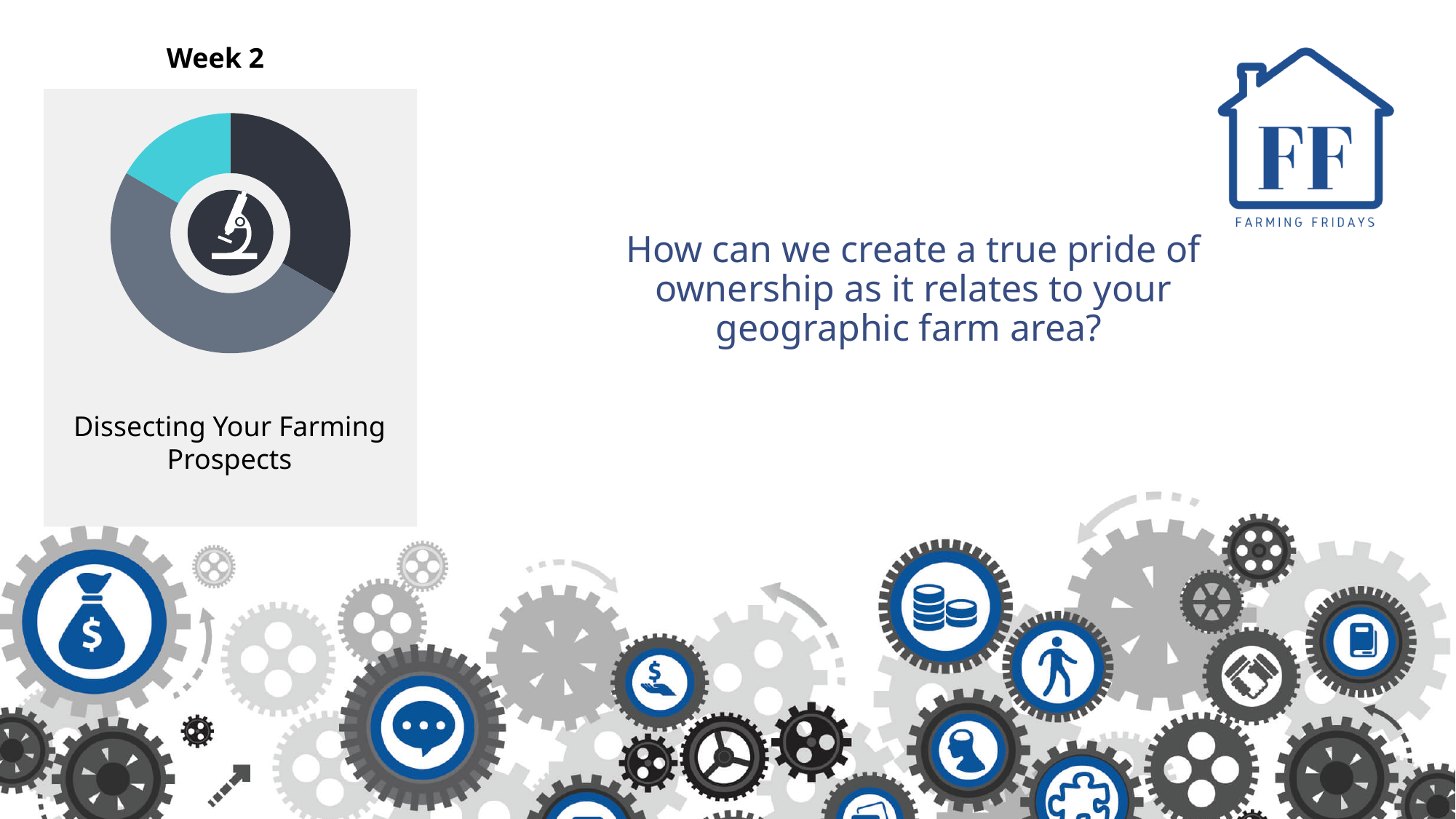
What kind of chart is shown in the 'Week 2' panel on the left of the slide? Pie chart (donut) How many segments does the donut chart in the 'Week 2' panel have? 3 What icon appears in the centre of the donut chart in the 'Week 2' panel? A microscope Is the teal segment of the donut chart in the 'Week 2' panel larger or smaller than the dark segment? Smaller What caption appears below the donut chart in the 'Week 2' panel? Dissecting Your Farming Prospects Which colour segment of the donut chart in the 'Week 2' panel is the smallest? Teal